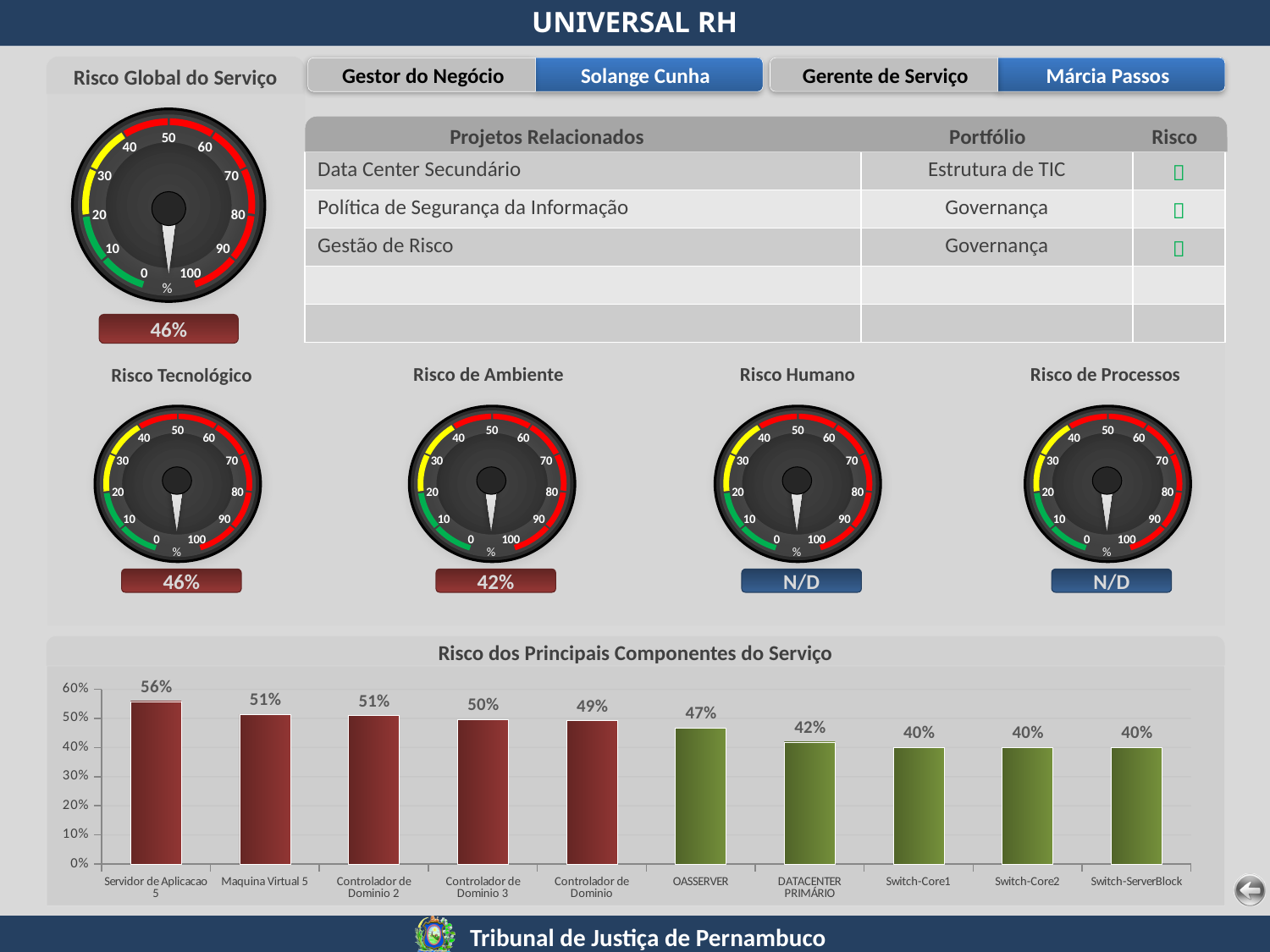
In the 'Risco dos Principais Componentes do Serviço' bar chart, which component has the highest value? Servidor de Aplicacao 5 In the 'Risco dos Principais Componentes do Serviço' bar chart, how many components are plotted? 10 In the 'Risco dos Principais Componentes do Serviço' bar chart, how many components have a value of 40%? 3 What value is shown below the 'Risco de Ambiente' gauge? 42% In the 'Risco dos Principais Componentes do Serviço' bar chart, what is the value for Servidor de Aplicacao 5? 56% In the 'Risco dos Principais Componentes do Serviço' bar chart, what is the value for DATACENTER PRIMÁRIO? 42% What value is shown below the 'Risco Global do Serviço' gauge? 46% In the 'Risco dos Principais Componentes do Serviço' bar chart, do the values rise or fall from left to right? Fall In the 'Risco dos Principais Componentes do Serviço' bar chart, which is larger, Controlador de Dominio 3 or OASSERVER? Controlador de Dominio 3 In the 'Risco dos Principais Componentes do Serviço' bar chart, what is the value for OASSERVER? 47% What kind of chart is 'Risco dos Principais Componentes do Serviço'? Bar chart In the 'Risco dos Principais Componentes do Serviço' bar chart, what is the difference between Servidor de Aplicacao 5 and Switch-Core1? 16%